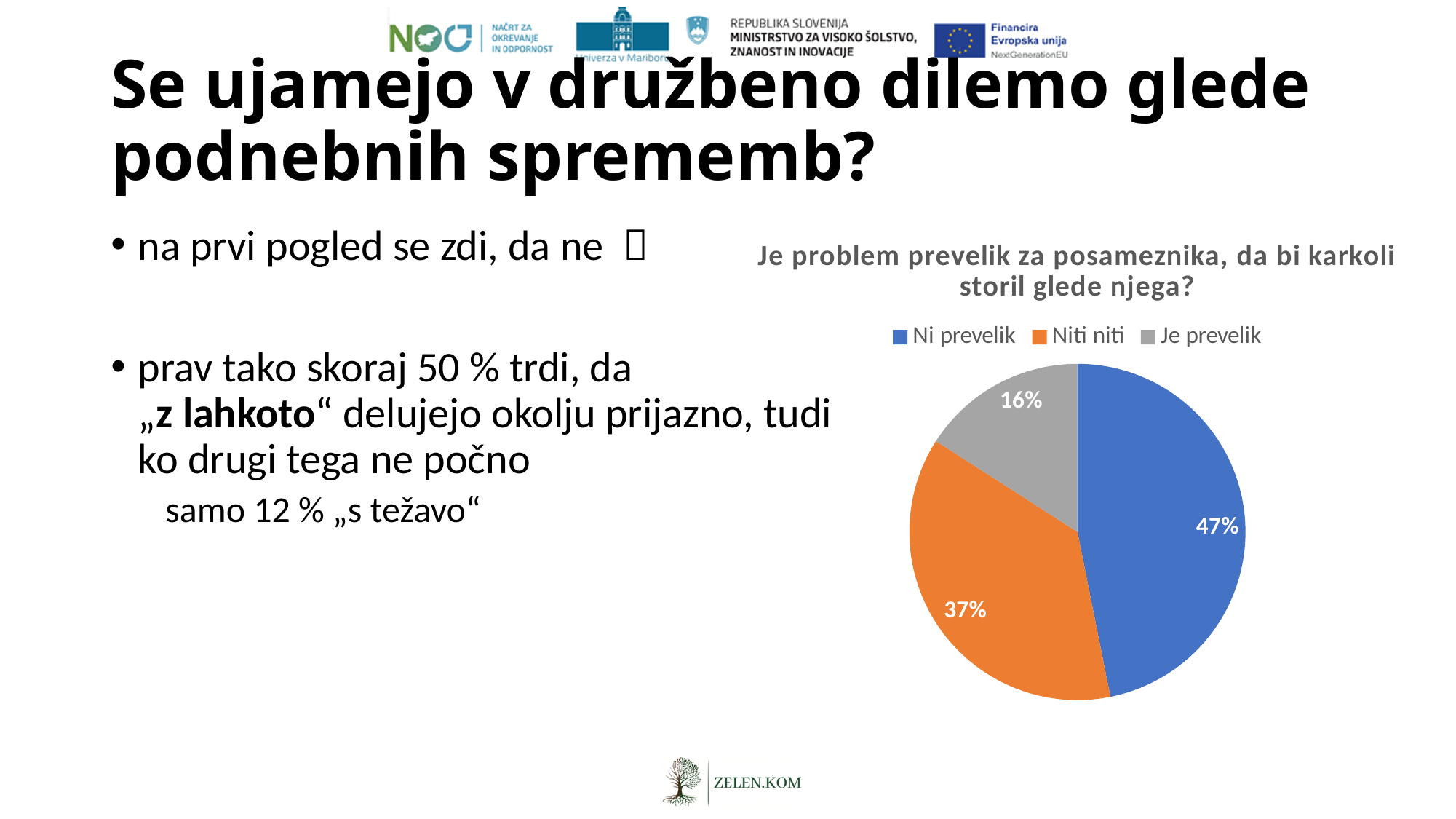
What is the difference in percentage points between the "Ni prevelik" and "Niti niti" slices? 10 What kind of chart is shown on the slide? pie chart What is the title of the chart? Je problem prevelik za posameznika, da bi karkoli storil glede njega? How many categories does the legend of the pie chart list? 3 What share of the pie is labelled "Ni prevelik"? 47% What is the difference in percentage points between the "Niti niti" and "Je prevelik" slices? 21 Which slice is larger, "Niti niti" or "Je prevelik"? Niti niti What share of the pie is labelled "Je prevelik"? 16% Which category has the smallest slice of the pie? Je prevelik Which category has the largest slice of the pie? Ni prevelik What colour is the "Niti niti" slice in the pie chart? orange What share of the pie is labelled "Niti niti"? 37%